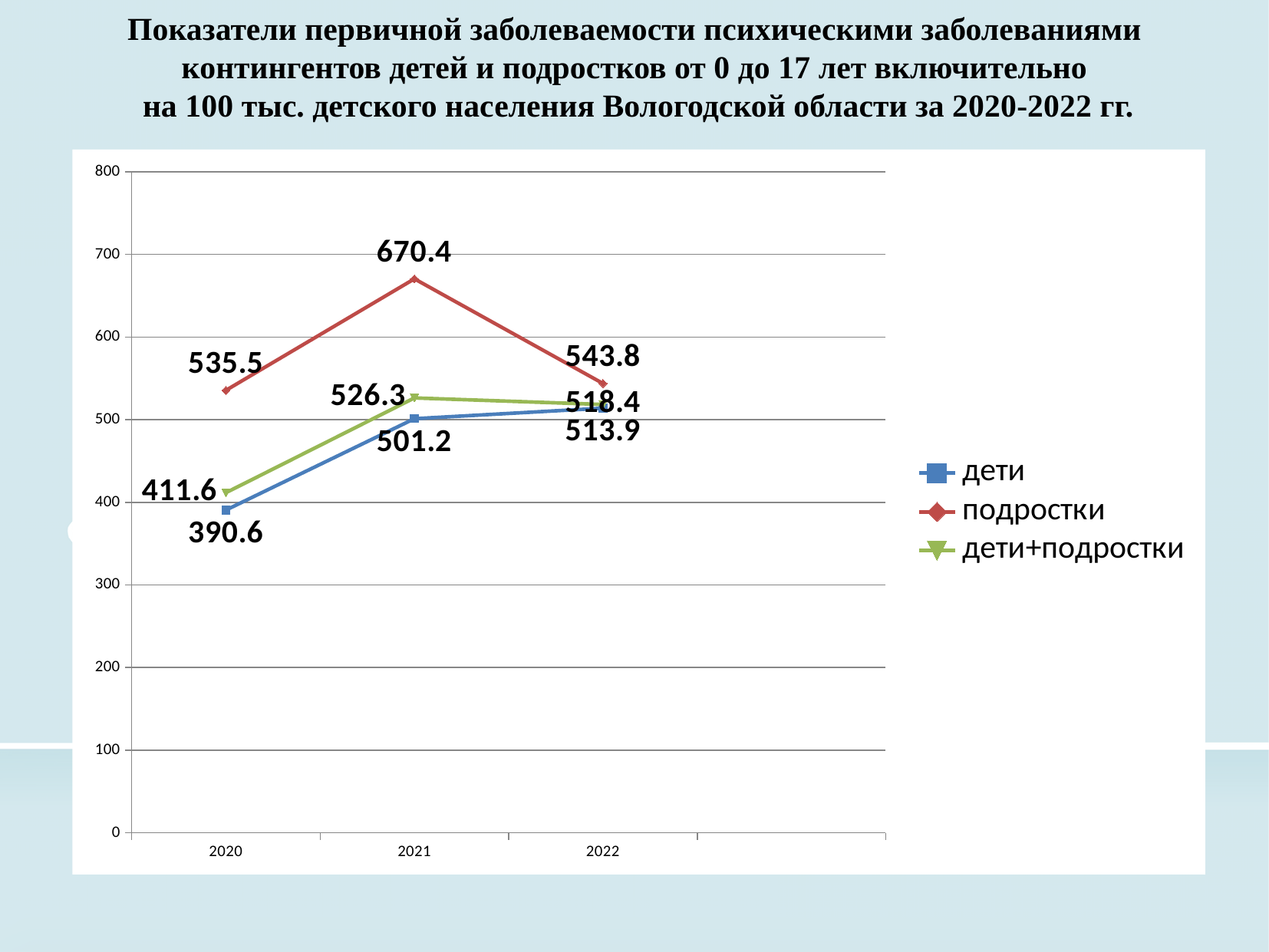
What is the difference between the подростки values in 2021 and 2020? 134.9 Which series is shown in red? подростки What is the value for дети+подростки in 2022? 518.4 Does the value for дети rise or fall from 2020 to 2022? rise How many years are shown on the x axis? 3 In which year is the value for подростки highest? 2021 What kind of chart is shown on the slide? line chart How many series does the legend list? 3 What is the value for подростки in 2021? 670.4 What is the value for дети in 2020? 390.6 Which is larger in 2020: the value for подростки or the value for дети? подростки In which year is the value for дети lowest? 2020